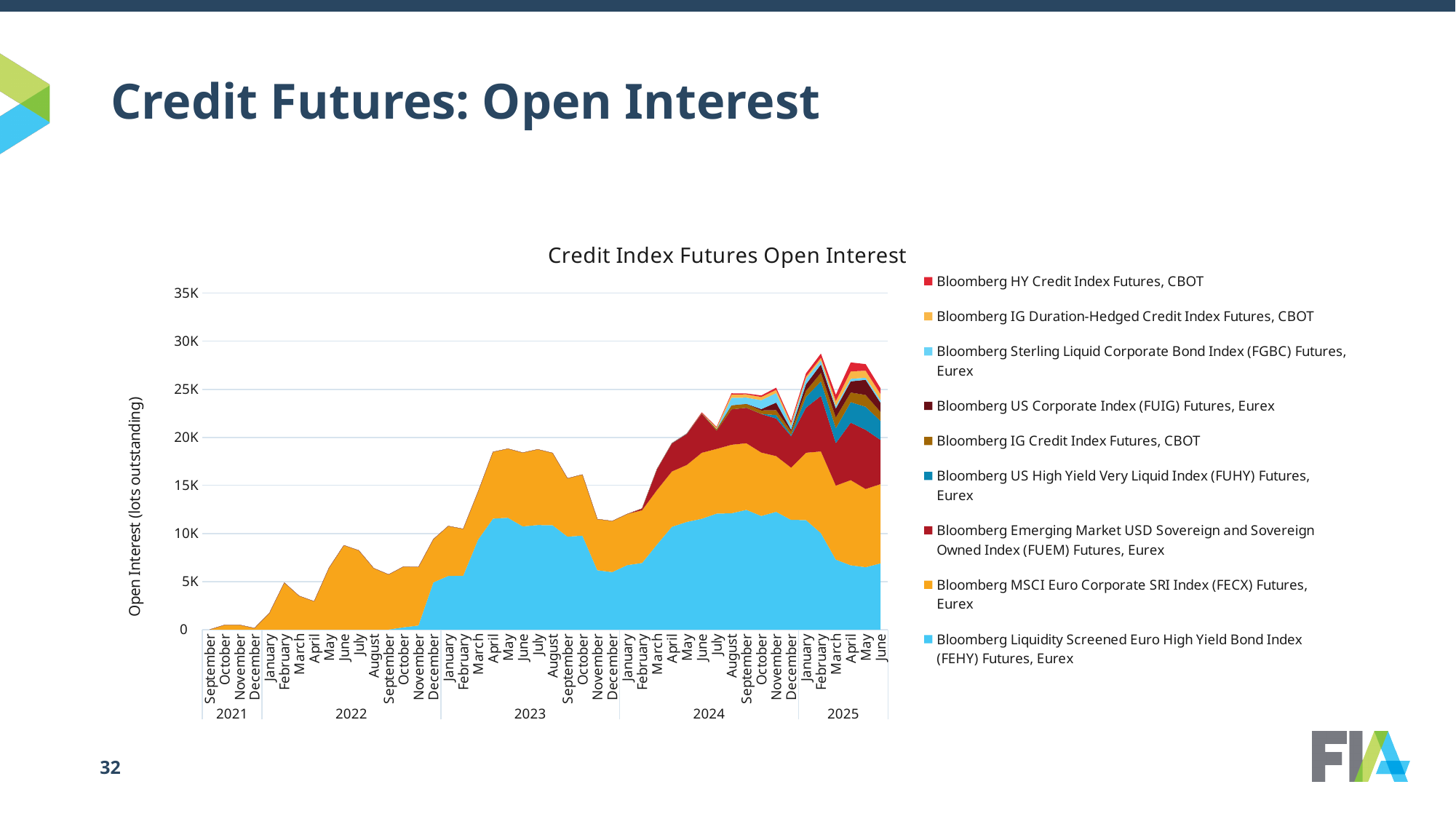
Is the total open interest in June 2025 greater or less than 20K? greater What is the title of the chart on the slide? Credit Index Futures Open Interest Overall, does total open interest rise or fall from September 2021 to June 2025? Rise Is the total open interest in February 2025 greater or less than 25K? greater What is the label on the vertical axis of the chart? Open Interest (lots outstanding) How many series does the legend of the Credit Index Futures Open Interest chart list? 9 Is the total open interest in April 2023 greater or less than 20K? less Which is larger, the total open interest in December 2022 or in December 2023? December 2023 Which month shows the highest total open interest on the chart? February 2025 What kind of chart is shown on the slide? Stacked area chart